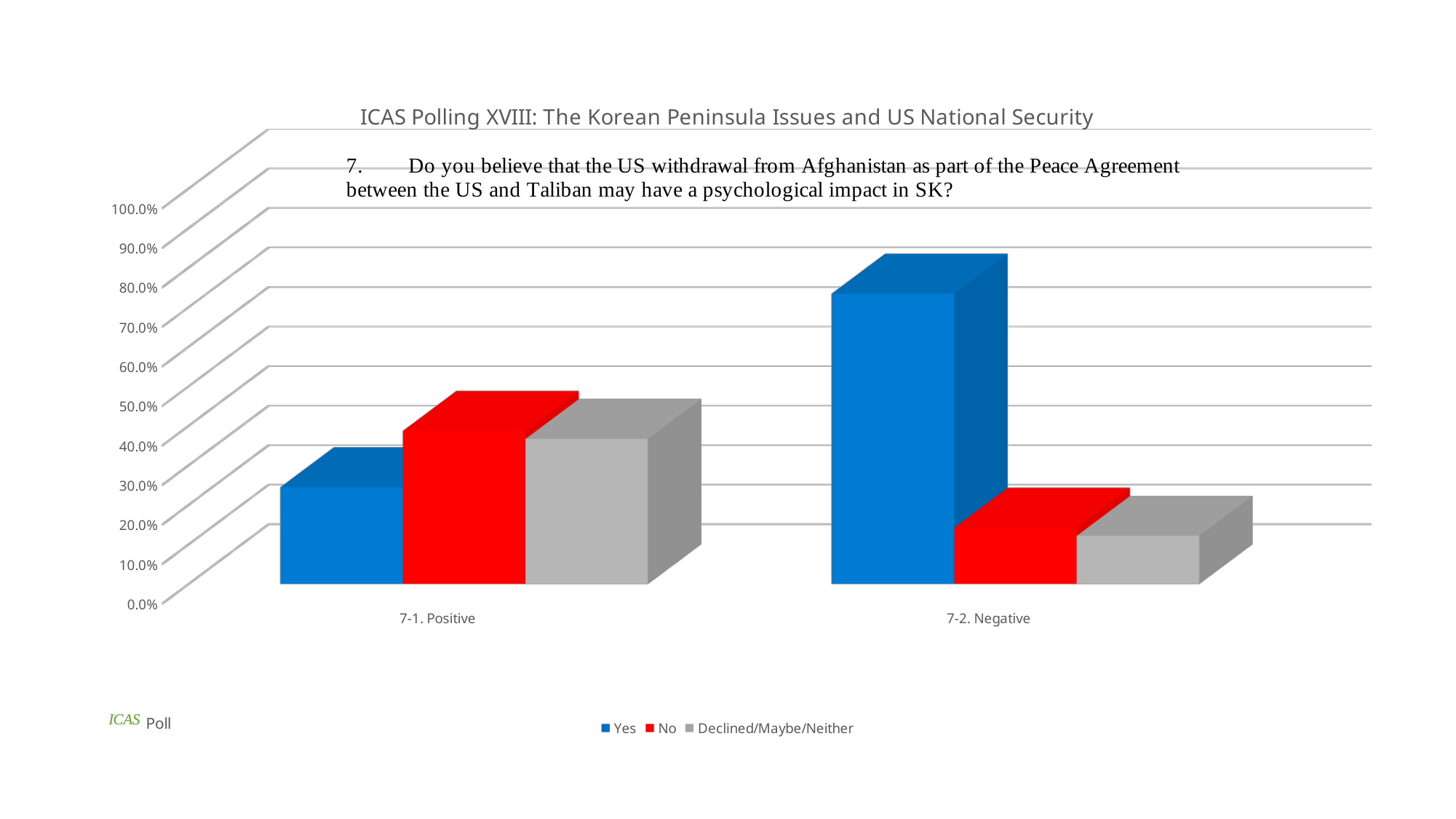
Is the value for Yes in 7-1. Positive greater or less than 40.0%? less What colour represents the Declined/Maybe/Neither series in the chart? gray Is the value for No in 7-1. Positive greater or less than 20.0%? greater Is the value for Yes in 7-2. Negative greater or less than 60.0%? greater How many series does the chart's legend list? 3 Which series has the lowest value for 7-1. Positive? Yes How many categories are shown on the x axis of the chart? 2 Which is larger: the No value for 7-1. Positive or the No value for 7-2. Negative? 7-1. Positive Which series has the highest value for 7-2. Negative? Yes What kind of chart is shown on the slide? bar chart Which is larger: the Yes value for 7-1. Positive or the Yes value for 7-2. Negative? 7-2. Negative